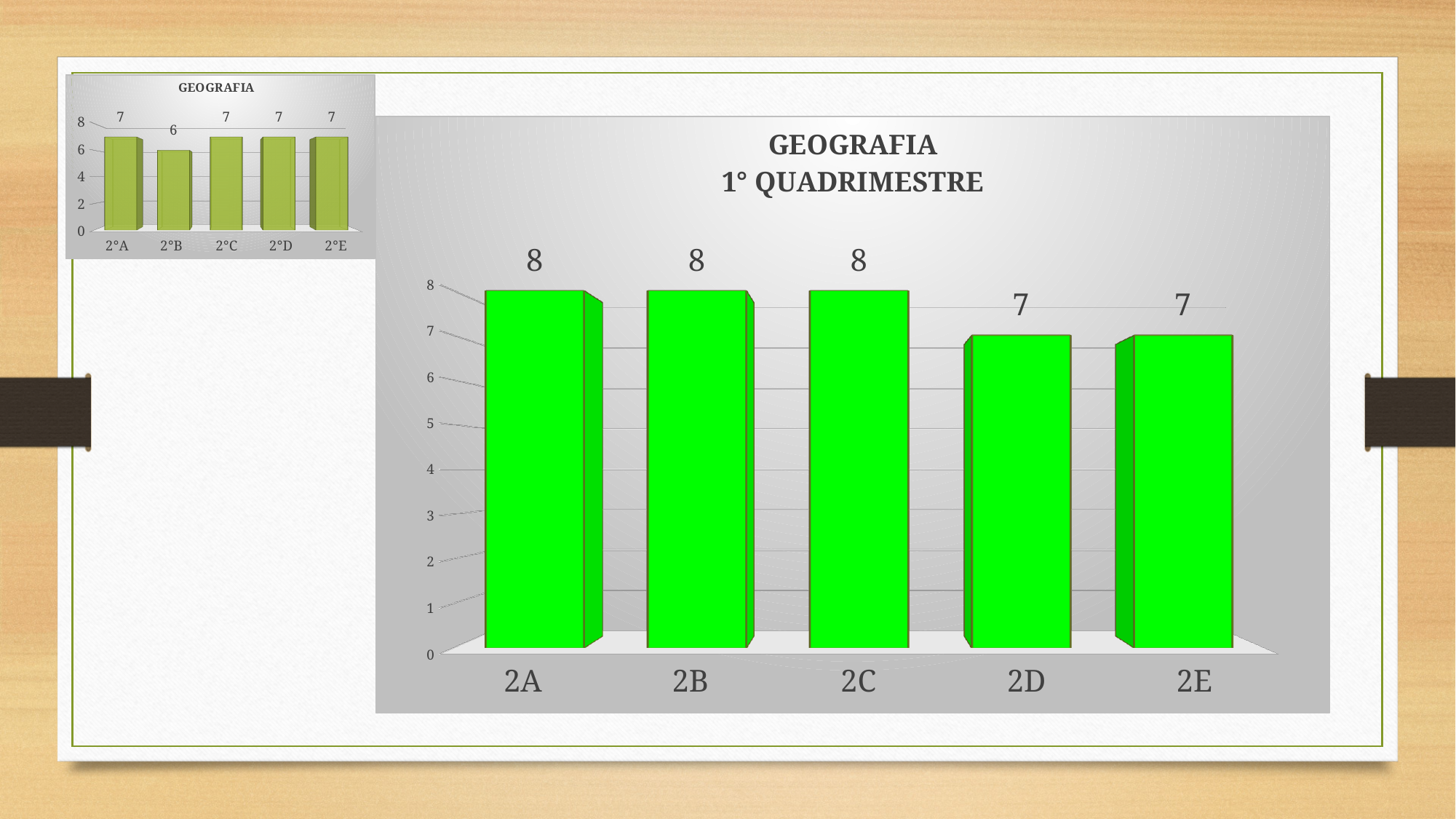
What is the title of the large chart on the slide? GEOGRAFIA 1° QUADRIMESTRE In the large chart titled GEOGRAFIA 1° QUADRIMESTRE, do the values rise or fall from 2A to 2E? fall In the large chart titled GEOGRAFIA 1° QUADRIMESTRE, what is the value for 2A? 8 What kind of chart is the large chart titled GEOGRAFIA 1° QUADRIMESTRE? bar chart In the large chart titled GEOGRAFIA 1° QUADRIMESTRE, what is the difference between the values for 2C and 2E? 1 In the large chart titled GEOGRAFIA 1° QUADRIMESTRE, which is larger, the value for 2B or the value for 2D? 2B In the small chart titled GEOGRAFIA in the top-left corner, what is the value for 2°B? 6 In the small chart titled GEOGRAFIA in the top-left corner, how many bars are shown? 5 In the large chart titled GEOGRAFIA 1° QUADRIMESTRE, how many categories are shown on the x axis? 5 In the large chart titled GEOGRAFIA 1° QUADRIMESTRE, what is the value for 2D? 7 In the small chart titled GEOGRAFIA in the top-left corner, what is the difference between the values for 2°A and 2°B? 1 In the small chart titled GEOGRAFIA in the top-left corner, which category has the lowest value? 2°B